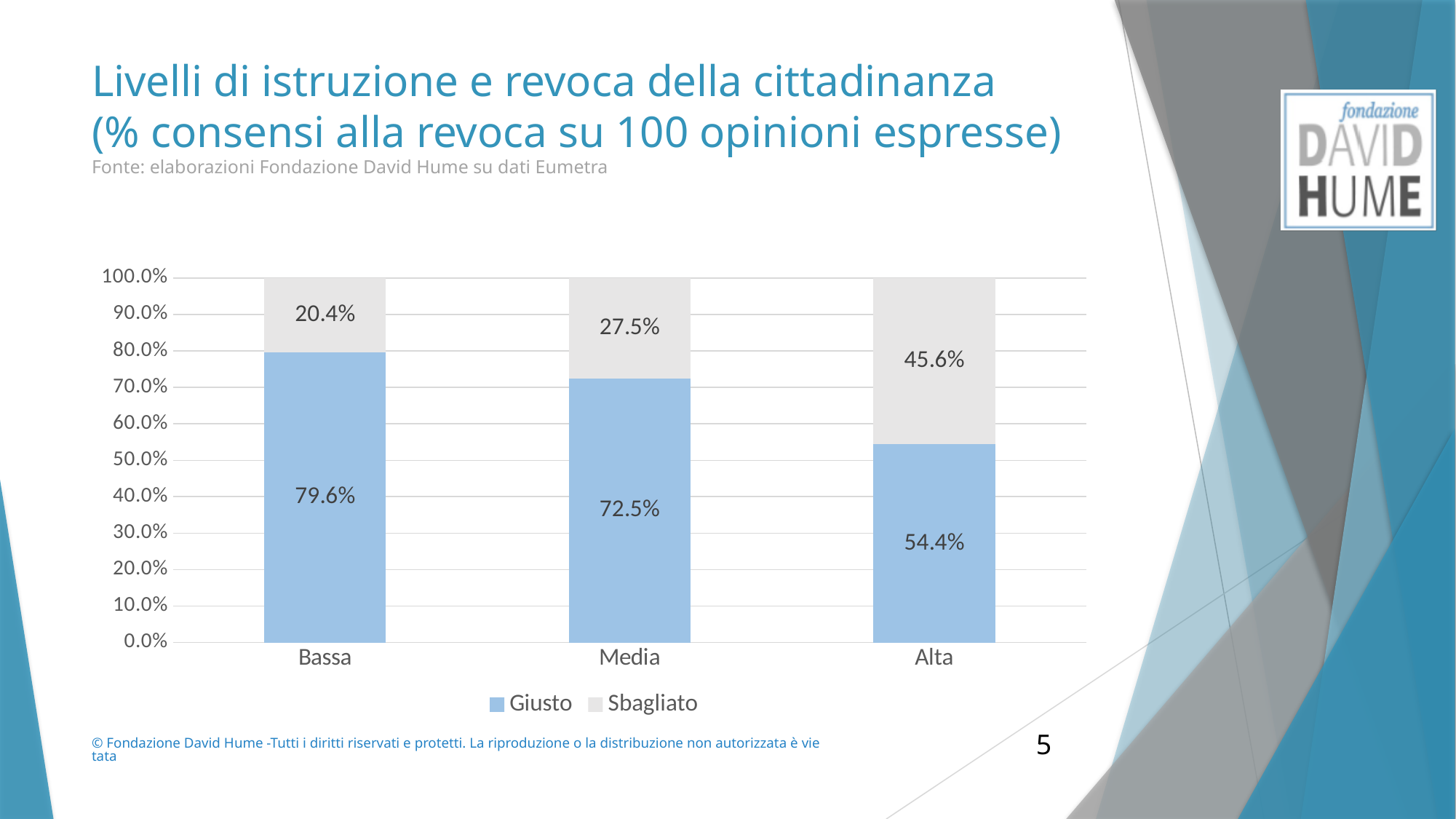
What is the Giusto value for Media? 72.5% Which education level has the highest Giusto value? Bassa What is the difference between the Giusto values for Bassa and Alta? 25.2% Which education level has the lowest Sbagliato value? Bassa How many series does the legend list? 2 What is the Giusto value for Bassa? 79.6% What is the total of the stacked bar for Media? 100.0% Which is larger: the Sbagliato value for Media or the Sbagliato value for Alta? Alta Do the Giusto values rise or fall moving from Bassa to Alta? Fall What is the Sbagliato value for Alta? 45.6% What kind of chart is shown on the slide? Stacked bar chart How many education levels are shown on the x axis? 3